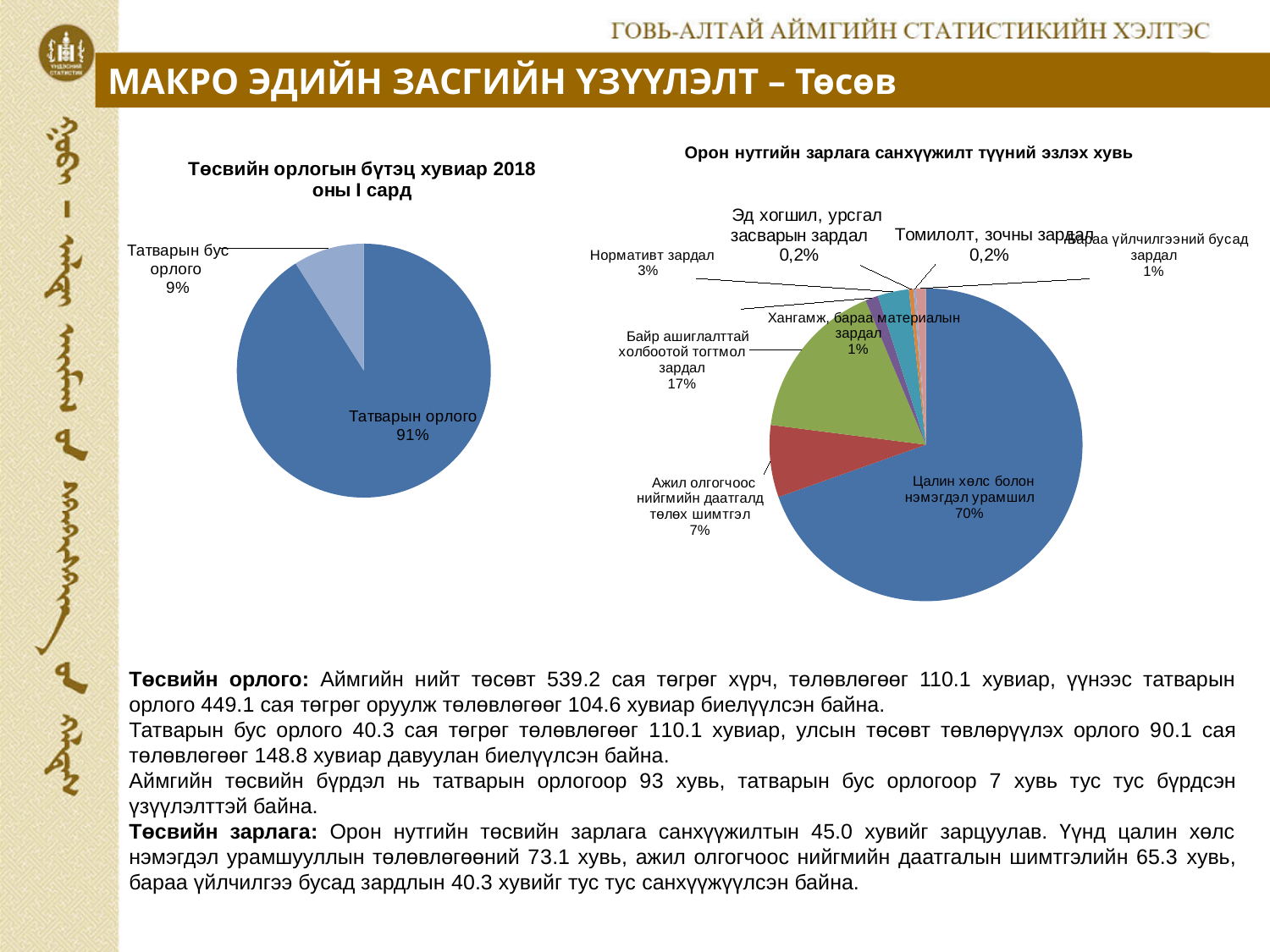
In the right chart 'Орон нутгийн зарлага санхүүжилт түүний эзлэх хувь', what share does 'Томилолт, зочны зардал' have? 0,2% In the left chart 'Төсвийн орлогын бүтэц хувиар 2018 оны I сард', what share does 'Татварын бус орлого' have? 9% In the left chart 'Төсвийн орлогын бүтэц хувиар 2018 оны I сард', how many slices does the pie have? 2 What type of chart is the left chart titled 'Төсвийн орлогын бүтэц хувиар 2018 оны I сард'? Pie chart In the right chart 'Орон нутгийн зарлага санхүүжилт түүний эзлэх хувь', which category has the largest share? Цалин хөлс болон нэмэгдэл урамшил In the right chart 'Орон нутгийн зарлага санхүүжилт түүний эзлэх хувь', which is larger: 'Байр ашиглалттай холбоотой тогтмол зардал' or 'Ажил олгогчоос нийгмийн даатгалд төлөх шимтгэл'? Байр ашиглалттай холбоотой тогтмол зардал In the right chart 'Орон нутгийн зарлага санхүүжилт түүний эзлэх хувь', what share does 'Нормативт зардал' have? 3% In the right chart 'Орон нутгийн зарлага санхүүжилт түүний эзлэх хувь', how many slices does the pie have? 8 In the left chart 'Төсвийн орлогын бүтэц хувиар 2018 оны I сард', what is the difference in percentage points between 'Татварын орлого' and 'Татварын бус орлого'? 82 percentage points